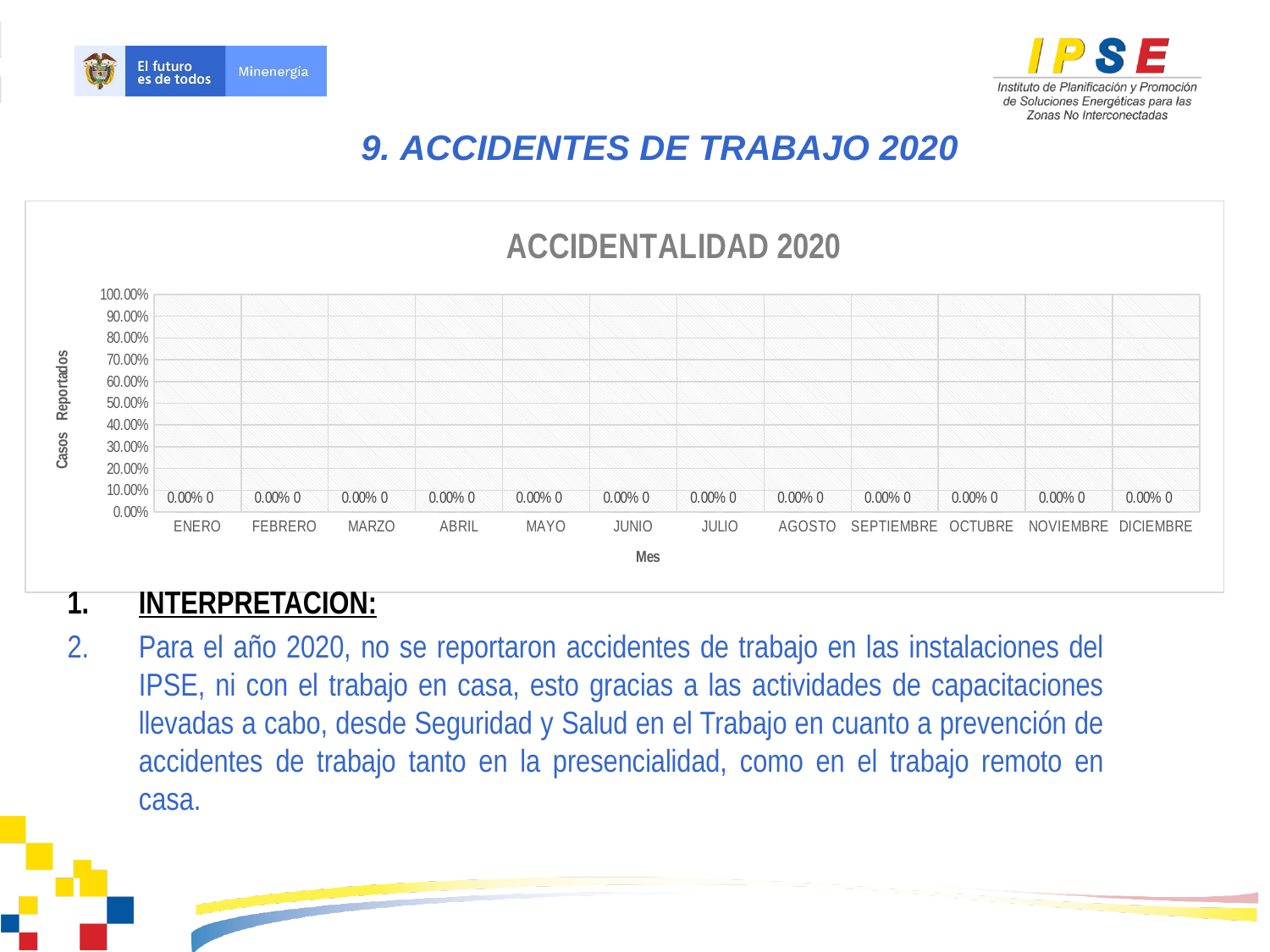
What is the total number of cases reported across all twelve months? 0 Do the values rise, fall, or stay flat from ENERO to DICIEMBRE? stay flat What percentage is shown for DICIEMBRE? 0.00% Which is larger, the value for ABRIL or the value for OCTUBRE, or are they equal? equal How many months (categories) are shown on the x axis of the chart? 12 What is the label of the x axis of the chart? Mes Is the value for MARZO greater or less than 50.00%? less What is the difference between the percentages for ENERO and FEBRERO? 0.00% What percentage is shown for ENERO in the ACCIDENTALIDAD 2020 chart? 0.00% How many cases are shown for JULIO in the chart? 0 What is the title of the chart? ACCIDENTALIDAD 2020